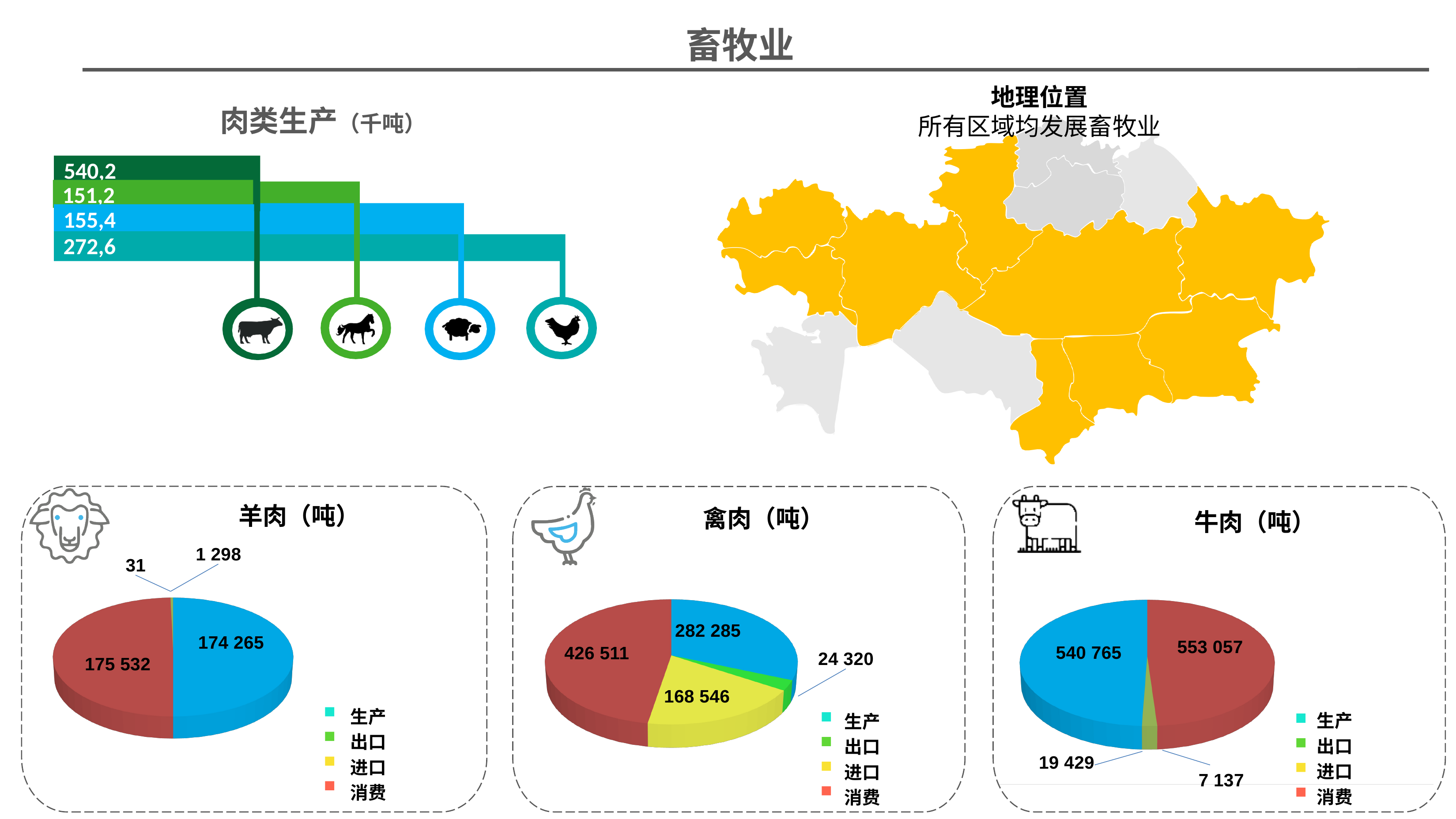
In the 禽肉（吨） pie chart, what is the value for 消费? 426 511 In the 羊肉（吨） pie chart, what is the value for 消费? 175 532 In the 牛肉（吨） pie chart, which is larger, 生产 or 消费? 消费 How many entries does the legend of the 牛肉（吨） pie chart list? 4 In the 羊肉（吨） pie chart, what is the value for 生产? 174 265 In the 肉类生产（千吨） chart, what is the highest value shown? 540,2 In the 肉类生产（千吨） chart, what is the lowest value shown? 151,2 What kind of chart is the 肉类生产（千吨） chart at the top left of the slide? bar chart In the 禽肉（吨） pie chart, what is the difference between 消费 (426 511) and 生产 (282 285)? 144 226 In the 禽肉（吨） pie chart, what is the value for 进口? 168 546 In the 羊肉（吨） pie chart, what is the smallest value shown? 31 How many bars are in the 肉类生产（千吨） chart? 4